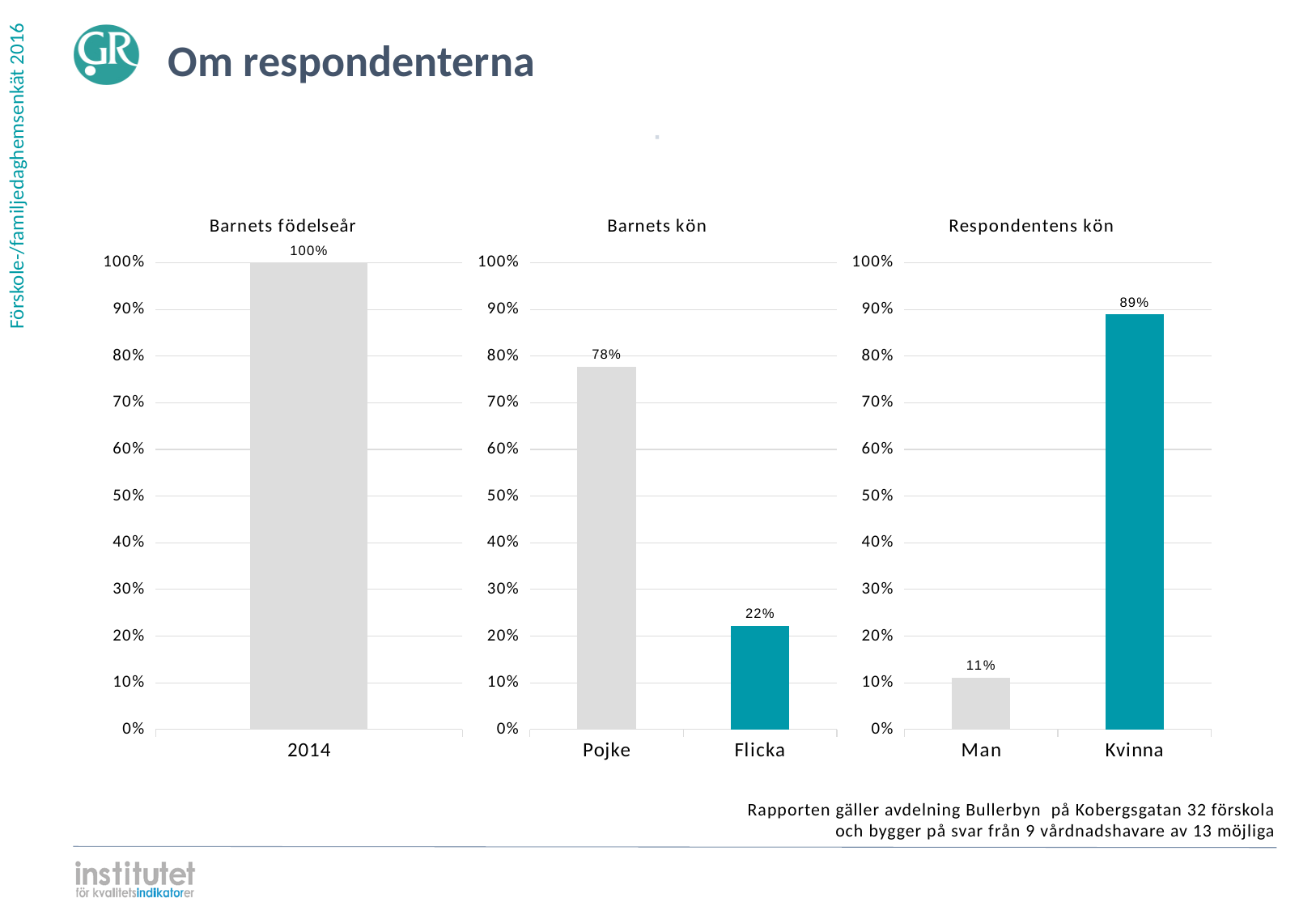
In the 'Respondentens kön' chart, what is the value for Kvinna? 89% In the 'Barnets födelseår' chart, what is the value for 2014? 100% In the 'Barnets kön' chart, what is the difference between the values for Pojke and Flicka? 56% What kind of chart is the 'Barnets kön' chart? Bar chart How many categories are shown in the 'Barnets födelseår' chart? 1 In the 'Barnets kön' chart, what is the value for Flicka? 22% In the 'Barnets kön' chart, what is the value for Pojke? 78% In the 'Respondentens kön' chart, which is larger, the value for Man or the value for Kvinna? Kvinna In the 'Respondentens kön' chart, what is the difference between the values for Kvinna and Man? 78% In the 'Respondentens kön' chart, which category has the lowest value? Man In the 'Respondentens kön' chart, what is the value for Man? 11% In the 'Barnets kön' chart, which category has the highest value? Pojke